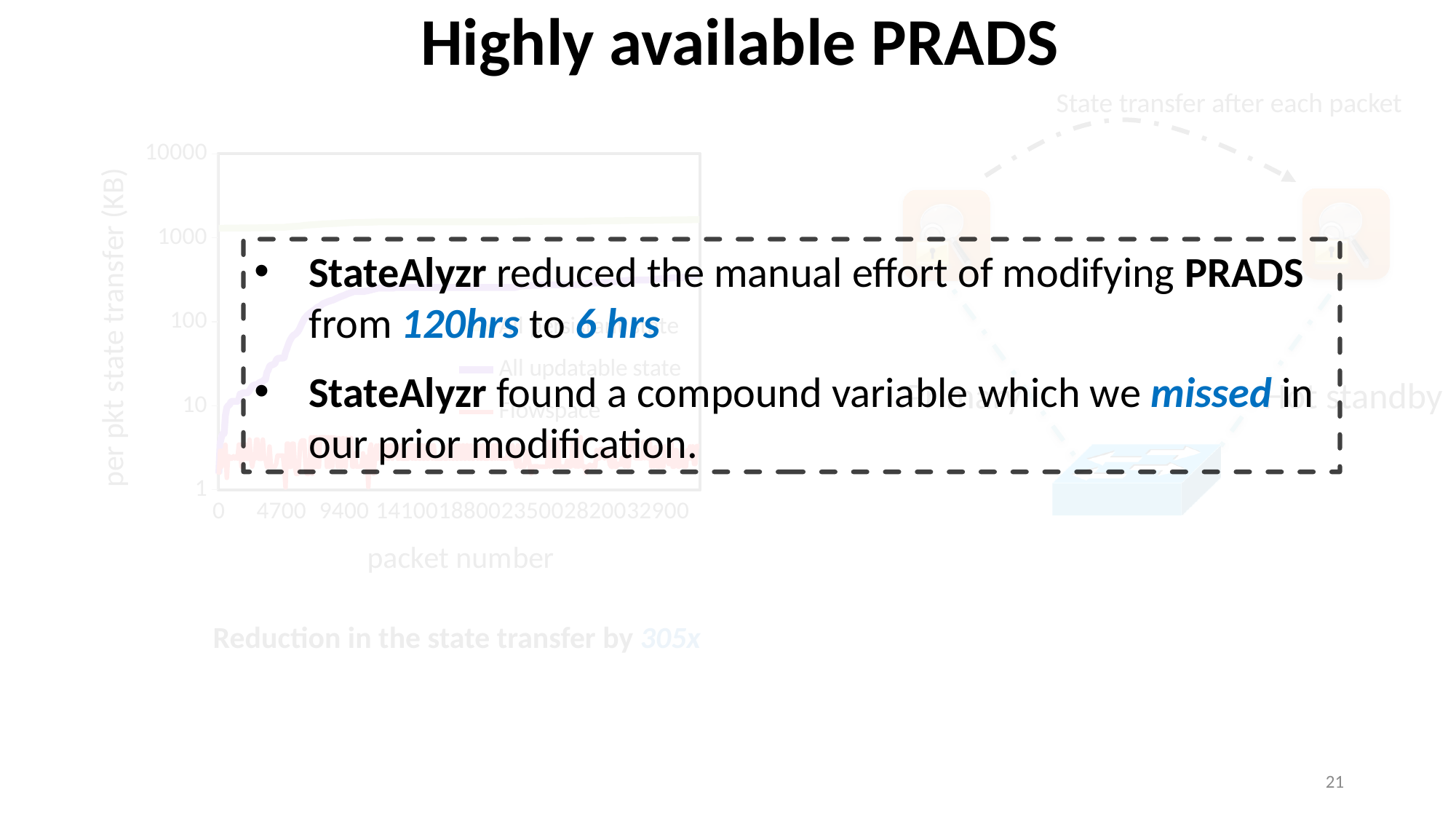
What is the largest tick value shown on the x axis of the chart? 32900 Is the value for the Flowspace series greater or less than 100 KB across the plotted packet numbers? less What is the largest tick value shown on the y axis of the chart? 10000 What kind of chart is shown on the slide? line chart What is the label of the y axis of the chart? per pkt state transfer (KB) What is the label of the x axis of the chart? packet number